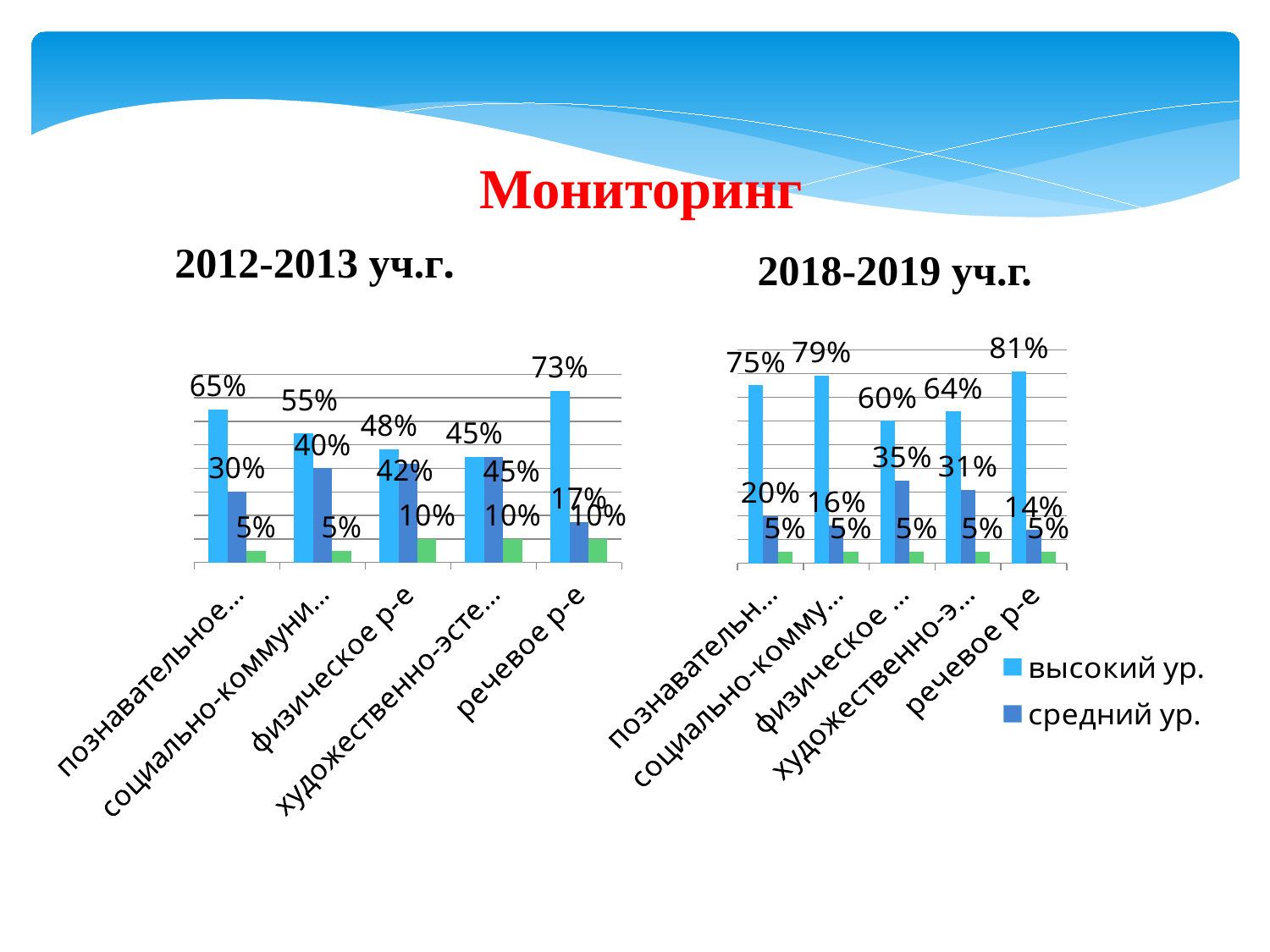
In the 2018-2019 уч.г. chart, which category has the highest высокий ур. value? речевое р-е In the 2012-2013 уч.г. chart, what is the value of высокий ур. for речевое р-е? 73% How many series does the legend on the slide list? 2 Which chart shows a larger высокий ур. value for речевое р-е, 2012-2013 уч.г. or 2018-2019 уч.г.? 2018-2019 уч.г. In the 2012-2013 уч.г. chart, what is the difference between the высокий ур. and средний ур. values for речевое р-е? 56% What is the title of the slide above the two charts? Мониторинг What type of chart is the 2012-2013 уч.г. chart? bar chart In the 2018-2019 уч.г. chart, what is the value of высокий ур. for речевое р-е? 81% In the 2012-2013 уч.г. chart, which category has the highest высокий ур. value? речевое р-е In the 2018-2019 уч.г. chart, what is the value of средний ур. for речевое р-е? 14% How many categories are shown on the x axis of the 2018-2019 уч.г. chart? 5 In the 2012-2013 уч.г. chart, what is the value of средний ур. for физическое р-е? 42%